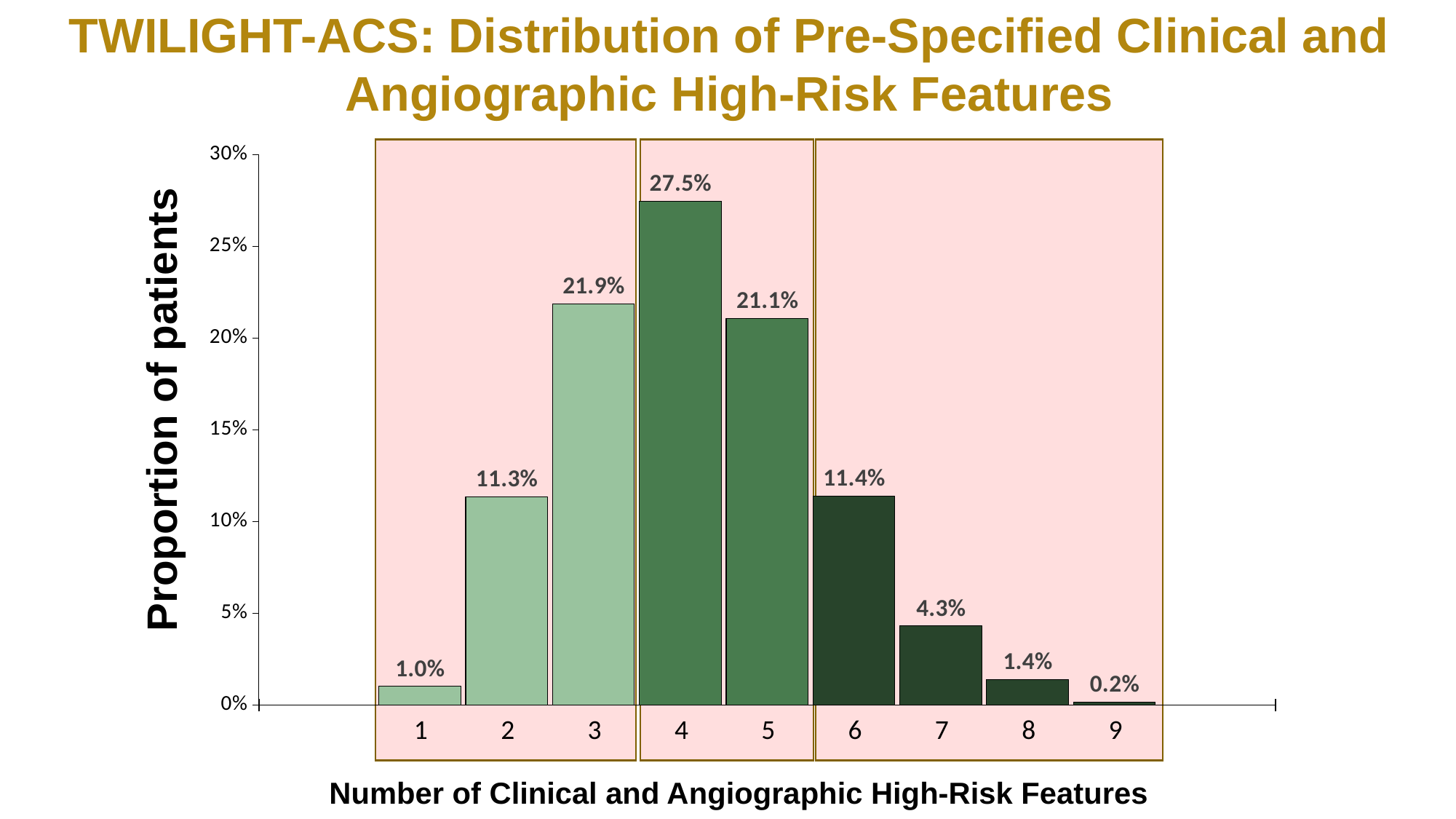
What proportion of patients had 9 high-risk features? 0.2% What is the label of the y axis? Proportion of patients How many categories (numbers of high-risk features) are shown on the x axis? 9 Which number of high-risk features has the highest proportion of patients? 4 Is the proportion of patients with 7 high-risk features greater or less than 5%? less What proportion of patients had 4 high-risk features? 27.5% What is the difference in proportion of patients between 4 and 6 high-risk features? 16.1% What proportion of patients had 2 high-risk features? 11.3% What is the difference in proportion of patients between 3 and 5 high-risk features? 0.8% Which has a larger proportion of patients: 3 high-risk features or 5 high-risk features? 3 Which number of high-risk features has the lowest proportion of patients? 9 What kind of chart is shown on the slide? bar chart